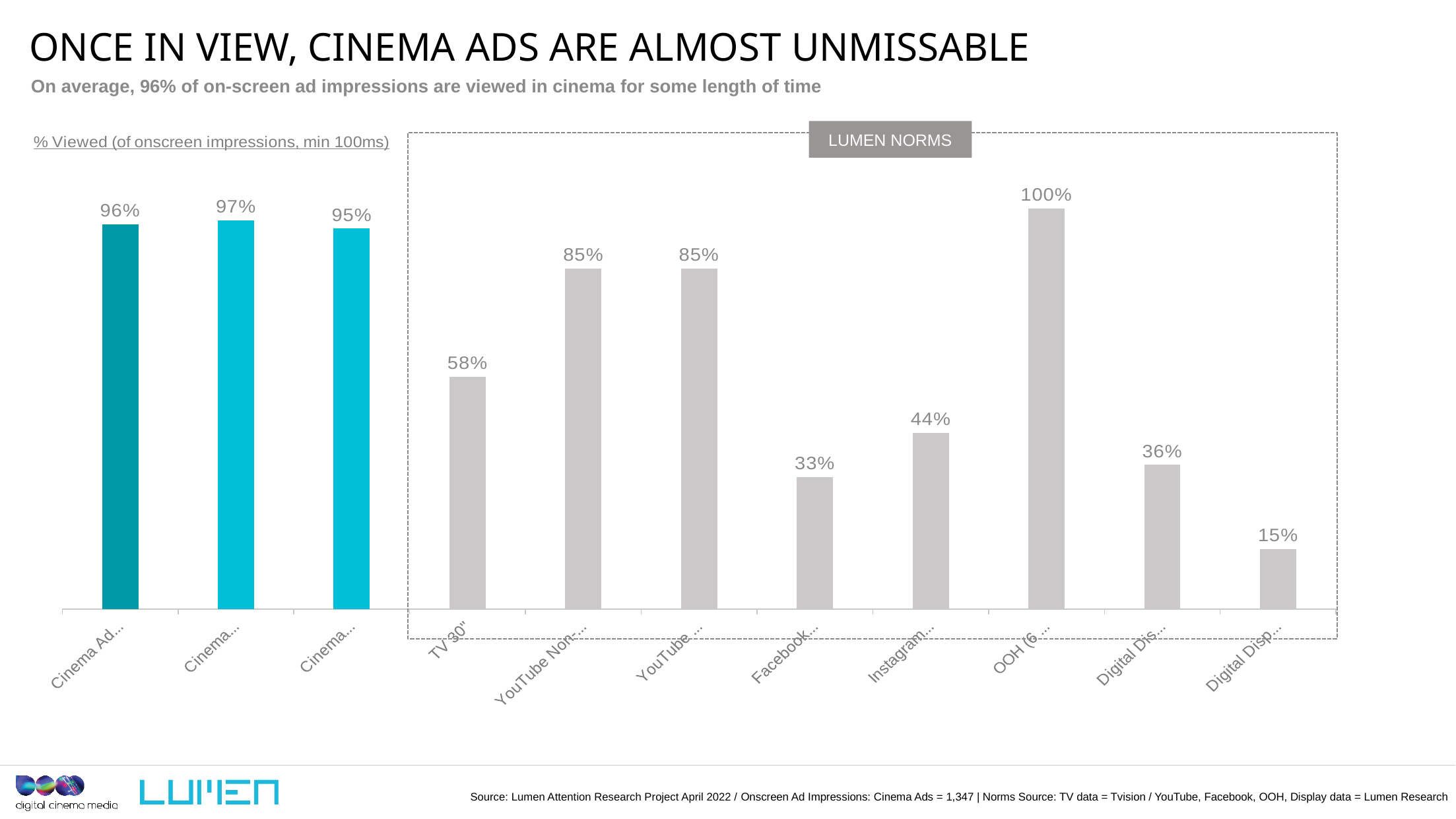
What is the lowest value shown on the chart? 15% What is the value for OOH? 100% What value is shown for the YouTube bars? 85% What is the difference between the values for OOH and TV 30"? 42% What is the value for Facebook? 33% What is the value for Instagram? 44% Which is larger, the value for Facebook or the value for Instagram? Instagram How many bars are shown on the chart? 11 Which category has the highest value? OOH What kind of chart is shown? Bar chart What is the value for the first bar, Cinema Ad...? 96% What is the value for TV 30"? 58%